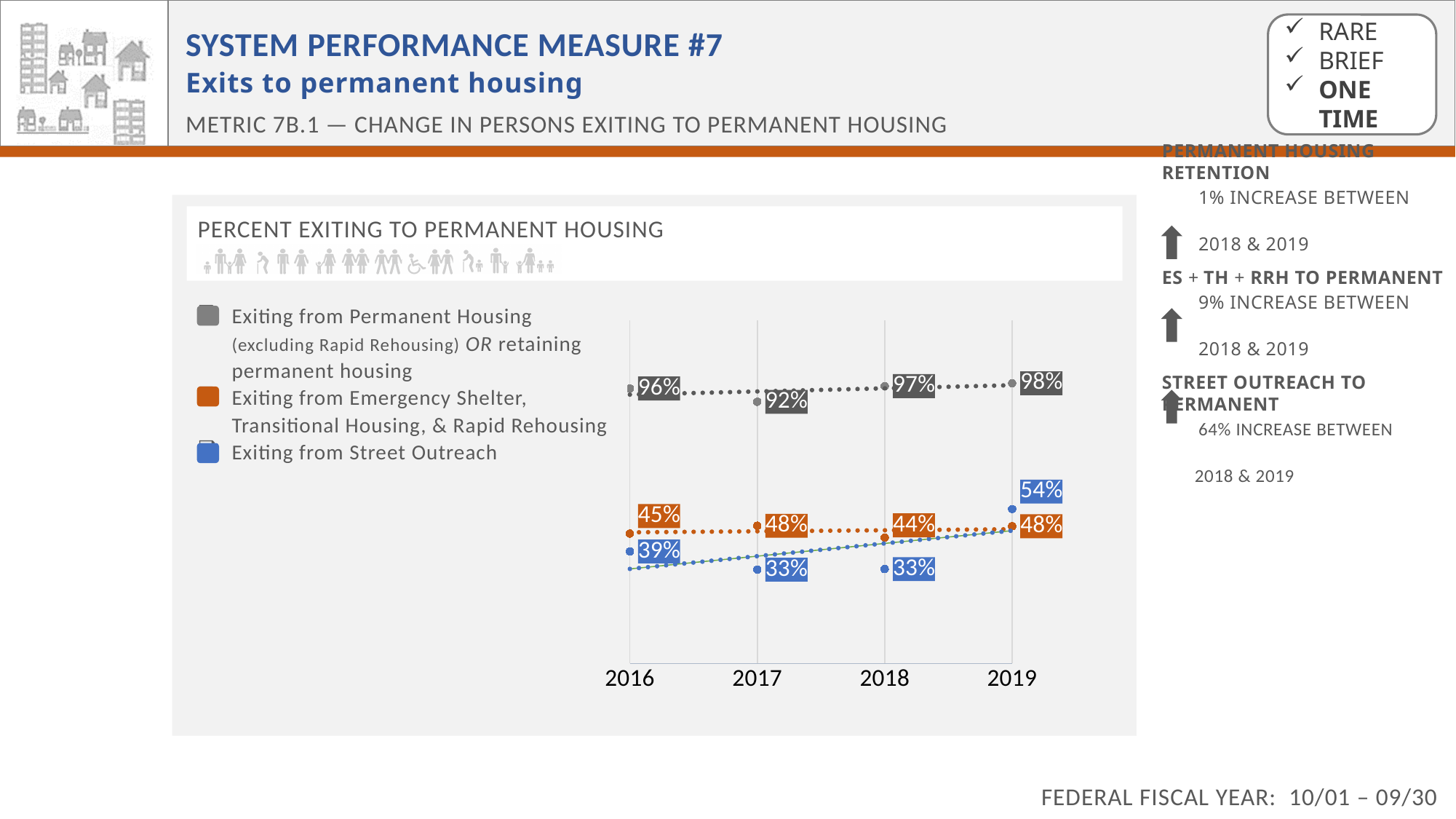
Which is larger in 2019: Exiting from Street Outreach or Exiting from Emergency Shelter, Transitional Housing, & Rapid Rehousing? Exiting from Street Outreach Does the Exiting from Street Outreach series rise or fall between 2018 and 2019? Rise What is the value for Exiting from Emergency Shelter, Transitional Housing, & Rapid Rehousing in 2018? 44% What is the difference between the Exiting from Street Outreach values for 2019 and 2018? 21% How many years are shown on the x axis? 4 How many series does the legend list? 3 What is the value for Exiting from Permanent Housing (excluding Rapid Rehousing) OR retaining permanent housing in 2017? 92% What is the title of the chart? PERCENT EXITING TO PERMANENT HOUSING What kind of chart is shown? Line chart In which year is the Exiting from Street Outreach series lowest? 2017 and 2018 What is the value for Exiting from Street Outreach in 2019? 54% In which year is the Exiting from Permanent Housing series highest? 2019